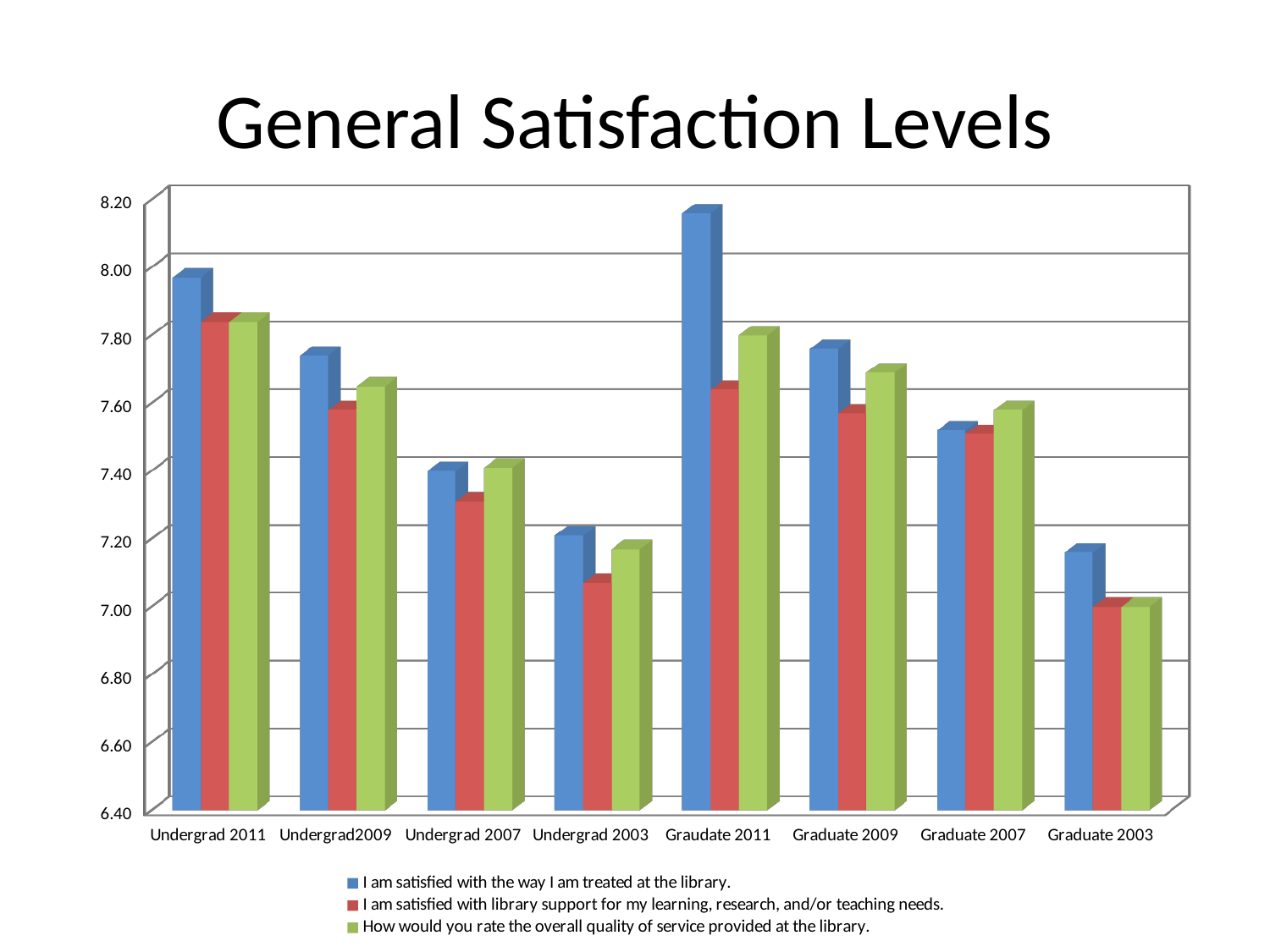
Is the value for Undergrad 2003 in the series 'I am satisfied with library support for my learning, research, and/or teaching needs.' greater or less than 7.20? less Is the value for Graudate 2011 in the series 'I am satisfied with the way I am treated at the library.' greater or less than 8.00? greater Which category has the highest value for the series 'I am satisfied with the way I am treated at the library.'? Graudate 2011 How many categories are shown along the x axis? 8 How many series does the legend list? 3 What is the title of the chart? General Satisfaction Levels What kind of chart is shown on the slide? bar chart Which category has the lowest value for the series 'I am satisfied with the way I am treated at the library.'? Graduate 2003 Which category has the highest value for the series 'I am satisfied with library support for my learning, research, and/or teaching needs.'? Undergrad 2011 Across the four Undergrad categories from left to right, does the series 'I am satisfied with the way I am treated at the library.' rise or fall? fall For the series 'I am satisfied with the way I am treated at the library.', which is larger: Undergrad 2011 or Graudate 2011? Graudate 2011 Is the value for Graduate 2009 in the series 'How would you rate the overall quality of service provided at the library.' greater or less than 7.80? less